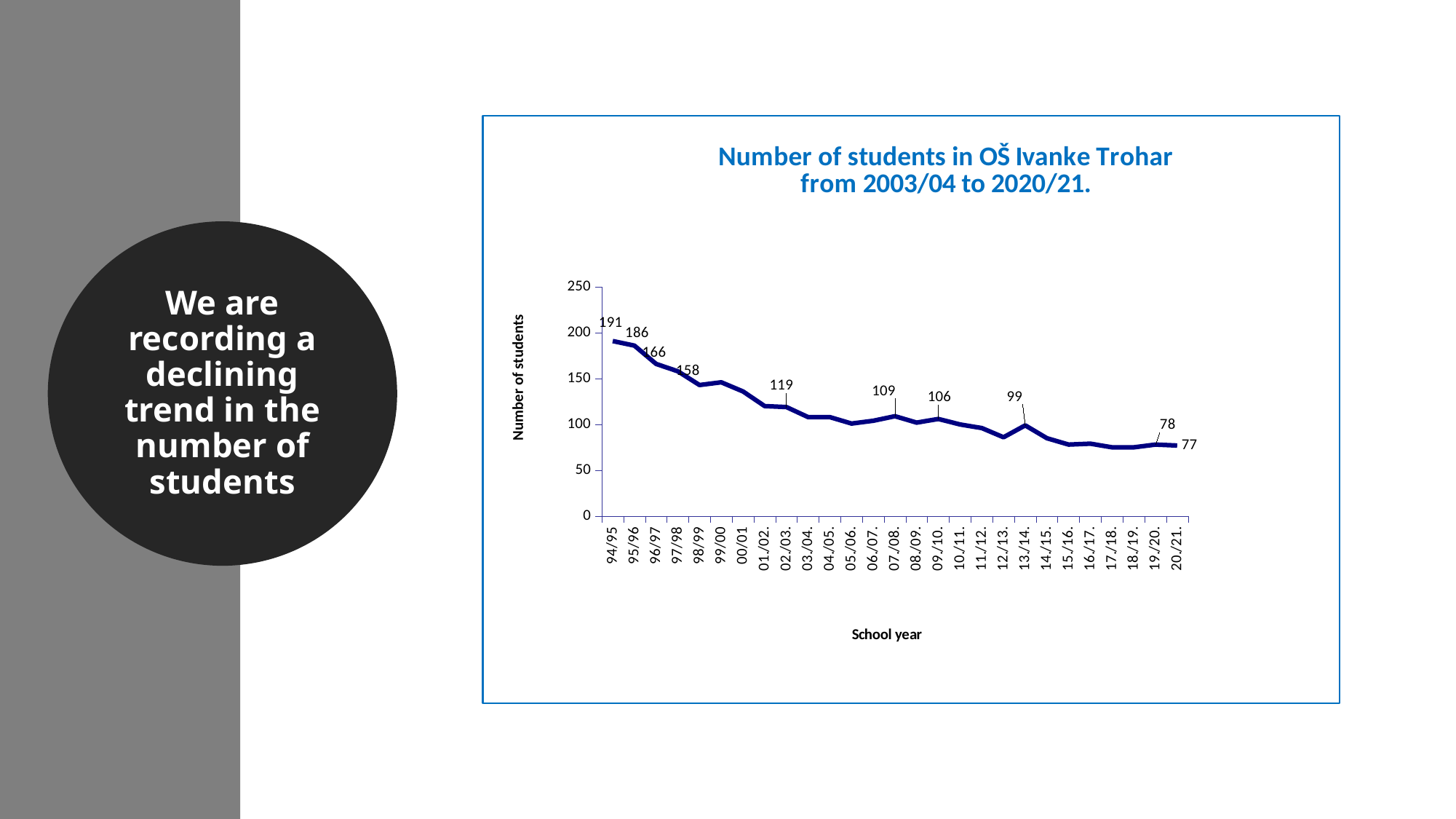
How many school years are shown on the x axis? 27 What is the number of students in the 20./21. school year? 77 Which school year has more students, 96/97 or 13./14.? 96/97 What is the difference between the number of students in 94/95 and in 20./21.? 114 Do the values rise or fall along the x axis overall? fall What is the number of students in the 13./14. school year? 99 Which school year has the highest number of students? 94/95 What is the number of students in the 94/95 school year? 191 What kind of chart is shown on the slide? line chart What is the label of the vertical axis? Number of students Is the number of students in 05./06. greater or less than 150? less What is the number of students in the 02./03. school year? 119